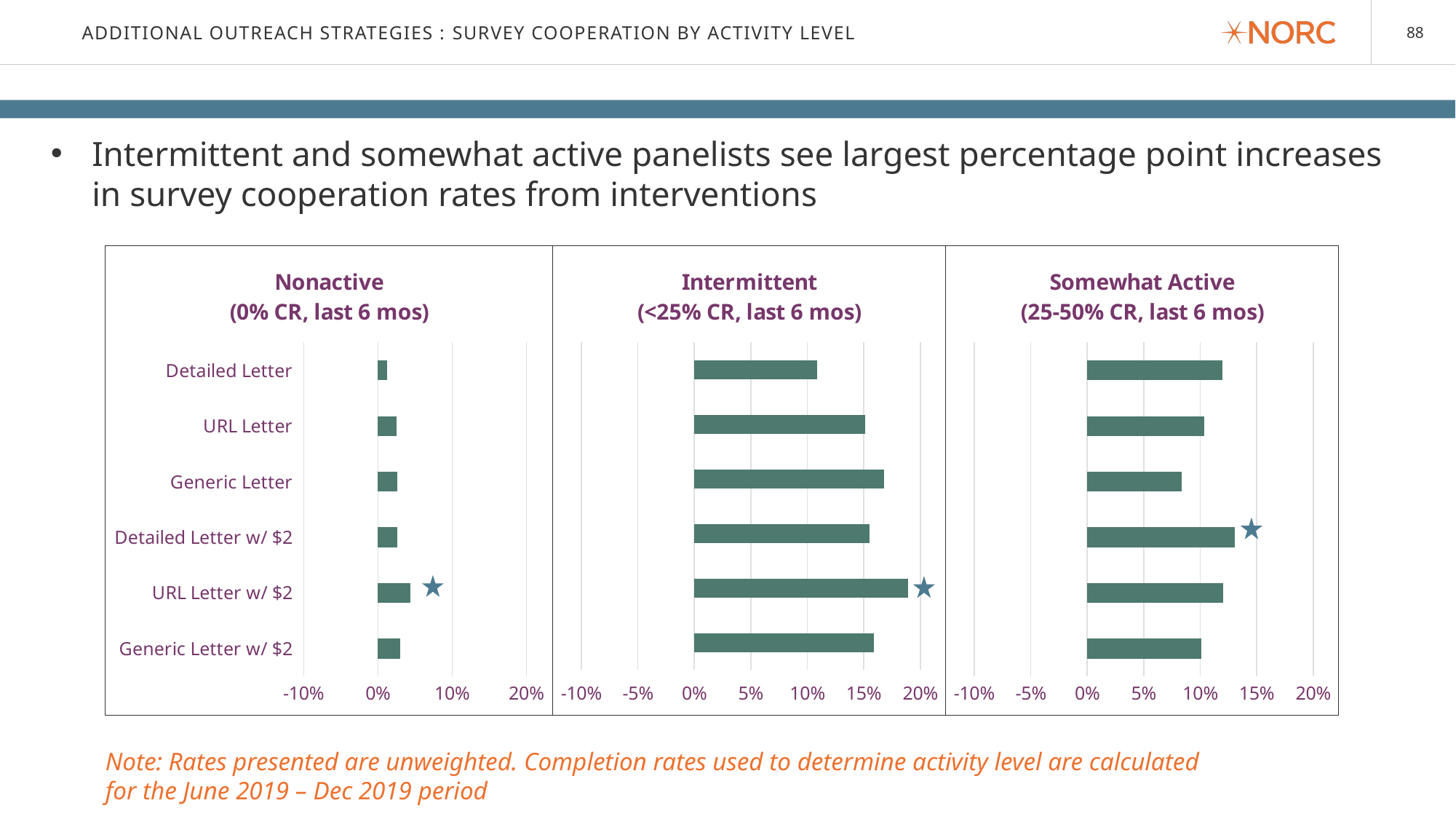
In the Somewhat Active chart, which intervention is marked with a star? Detailed Letter w/ $2 In the Nonactive chart, which intervention has the highest value? URL Letter w/ $2 In the Somewhat Active chart, which intervention has the lowest value? Generic Letter In the Nonactive chart, which intervention has the lowest value? Detailed Letter In the Intermittent chart, which intervention has the highest value? URL Letter w/ $2 In the Somewhat Active chart, is the value for Generic Letter greater or less than 10%? less In the Intermittent chart, which intervention has the lowest value? Detailed Letter In the Nonactive chart, is the value for URL Letter w/ $2 greater or less than 10%? less In the Intermittent chart, is the value for Generic Letter greater or less than 15%? greater How many intervention categories are listed in the Intermittent chart? 6 What kind of chart is used in the Nonactive panel? Bar chart In the Intermittent chart, which is larger: Generic Letter or Detailed Letter? Generic Letter